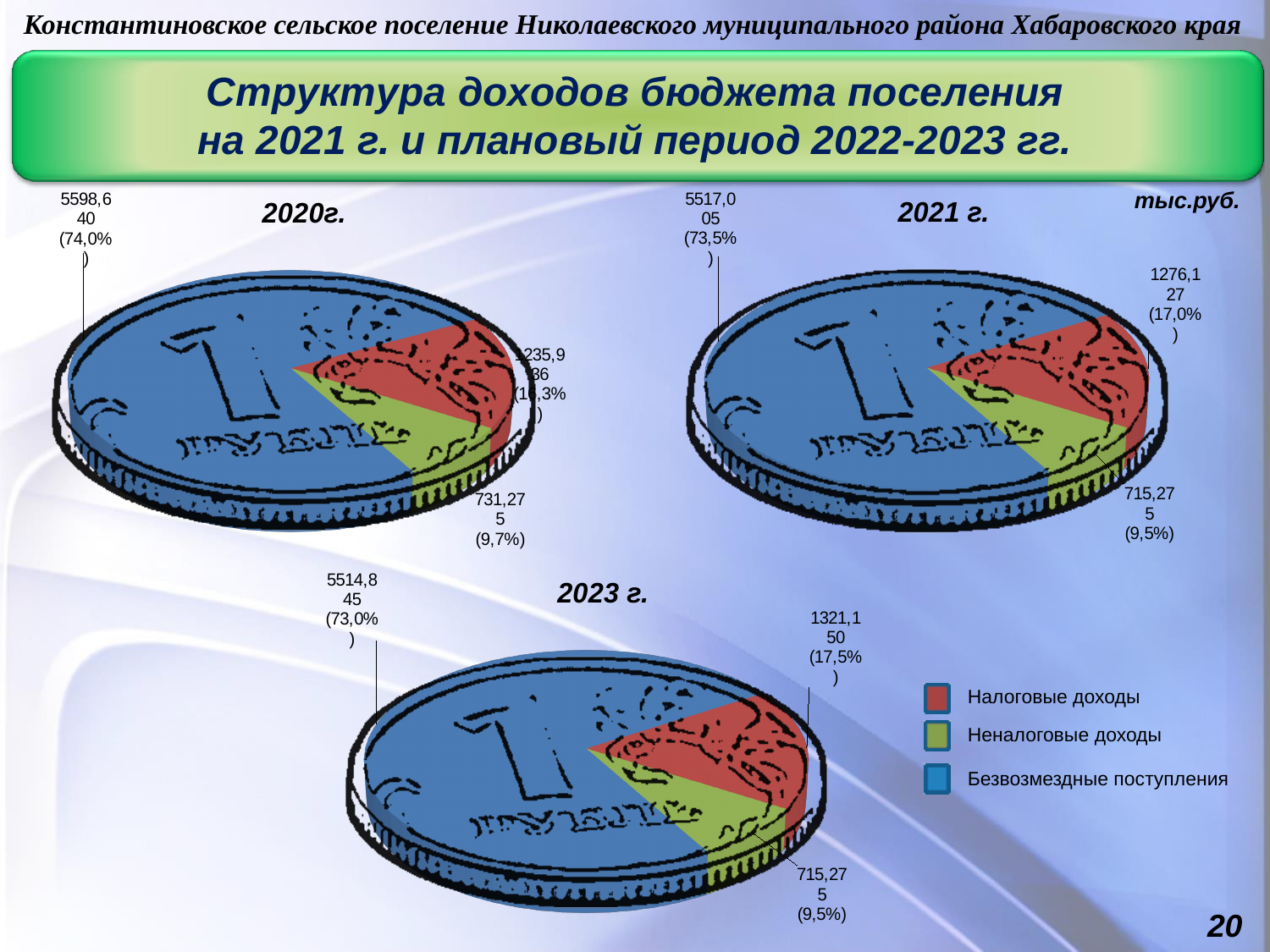
How many series does the legend list? 3 What is the difference between Безвозмездные поступления in the 2020г. chart and in the 2021 г. chart? 81,635 In the 2023 г. chart, which category has the largest slice? Безвозмездные поступления In the 2023 г. chart, what is the value for Неналоговые доходы? 715,275 (9,5%) Which is larger: Налоговые доходы in the 2021 г. chart or Налоговые доходы in the 2023 г. chart? 2023 г. In the 2020г. chart, what is the value for Безвозмездные поступления? 5598,640 (74,0%) In the 2021 г. chart, what share of the pie is Безвозмездные поступления? 73,5% In the 2021 г. chart, which category has the smallest slice? Неналоговые доходы What kind of chart is used for each year on this slide? pie chart Which colour represents Налоговые доходы in the legend? red In the 2021 г. chart, what is the value for Налоговые доходы? 1276,127 (17,0%) In the 2020г. chart, what share of the pie is Неналоговые доходы? 9,7%